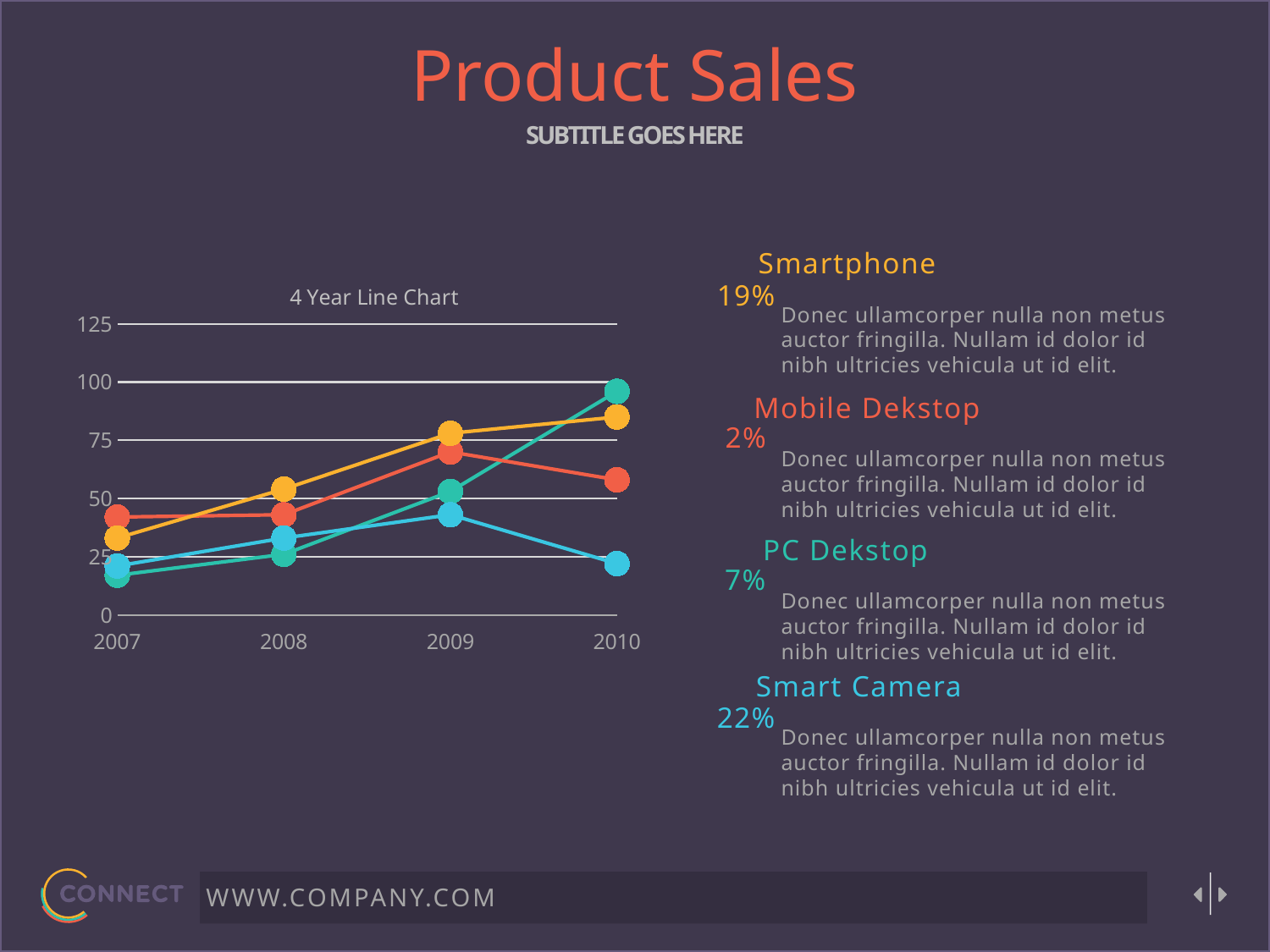
Is the value of the teal (green) line in 2010 greater or less than 75? greater What is the title of the chart? 4 Year Line Chart Is the value of the red line in 2009 greater or less than 50? greater Does the teal (green) line rise or fall from 2007 to 2010? rises What kind of chart is shown on the slide? line chart Is the value of the teal (green) line in 2007 greater or less than 25? less Which line has the lowest value in 2010? the light blue line How many years are shown along the x axis of the chart? 4 Which line has the highest value in 2010? the teal (green) line In 2008, which is higher: the yellow line or the red line? the yellow line How many lines are plotted in the chart? 4